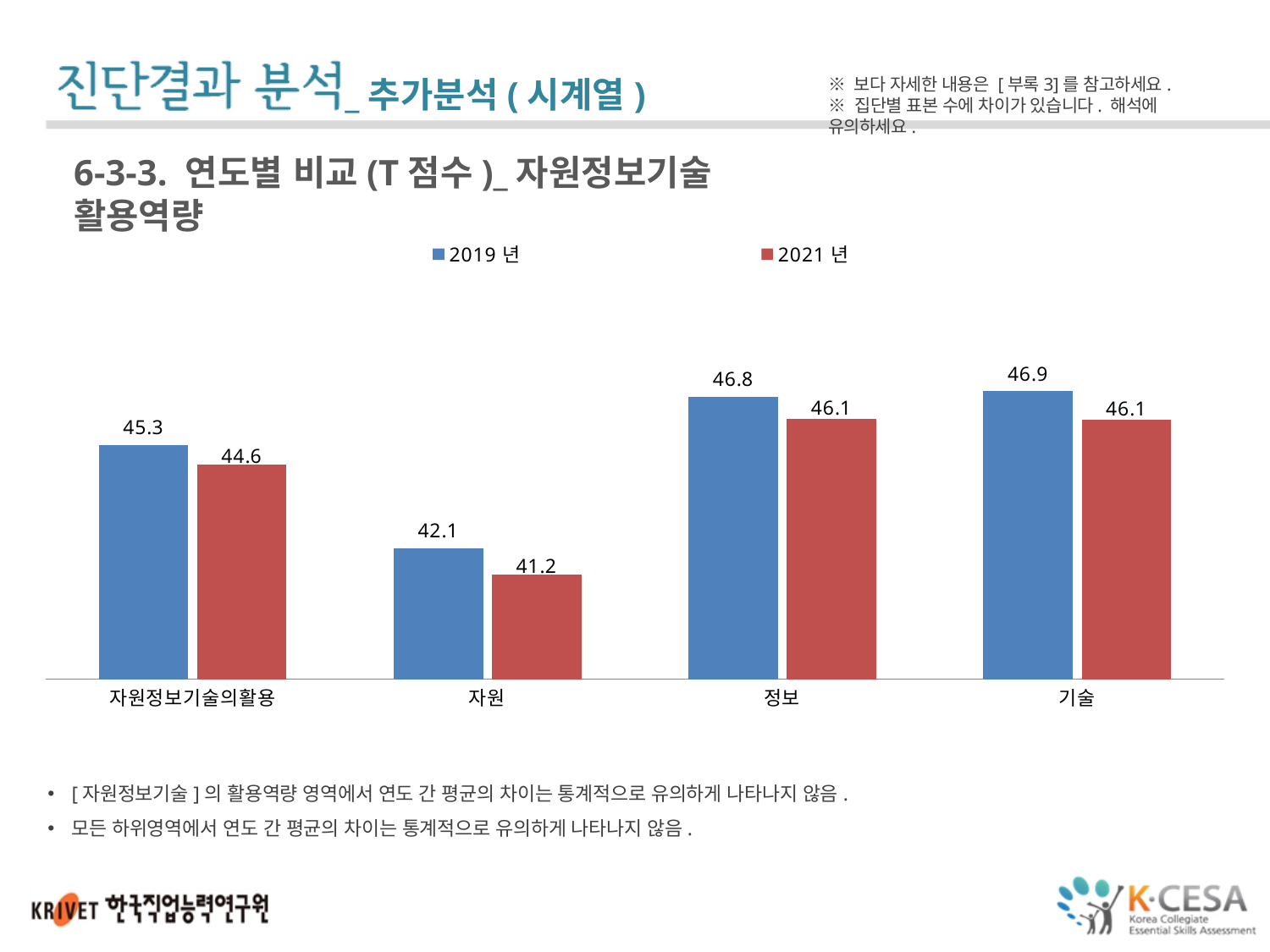
What is the 2021 년 value for 자원? 41.2 What is the 2019 년 value for 기술? 46.9 Which category has the lowest 2021 년 value? 자원 Which category has the highest 2019 년 value? 기술 What is the difference between the 2019 년 and 2021 년 values for 정보? 0.7 Which is larger for 자원정보기술의활용: the 2019 년 value or the 2021 년 value? 2019 년 How many categories are shown on the x axis? 4 What is the 2019 년 value for 자원정보기술의활용? 45.3 What is the difference between the 2019 년 and 2021 년 values for 자원? 0.9 What is the 2021 년 value for 정보? 46.1 How many series does the legend list? 2 What kind of chart is shown on the slide? bar chart